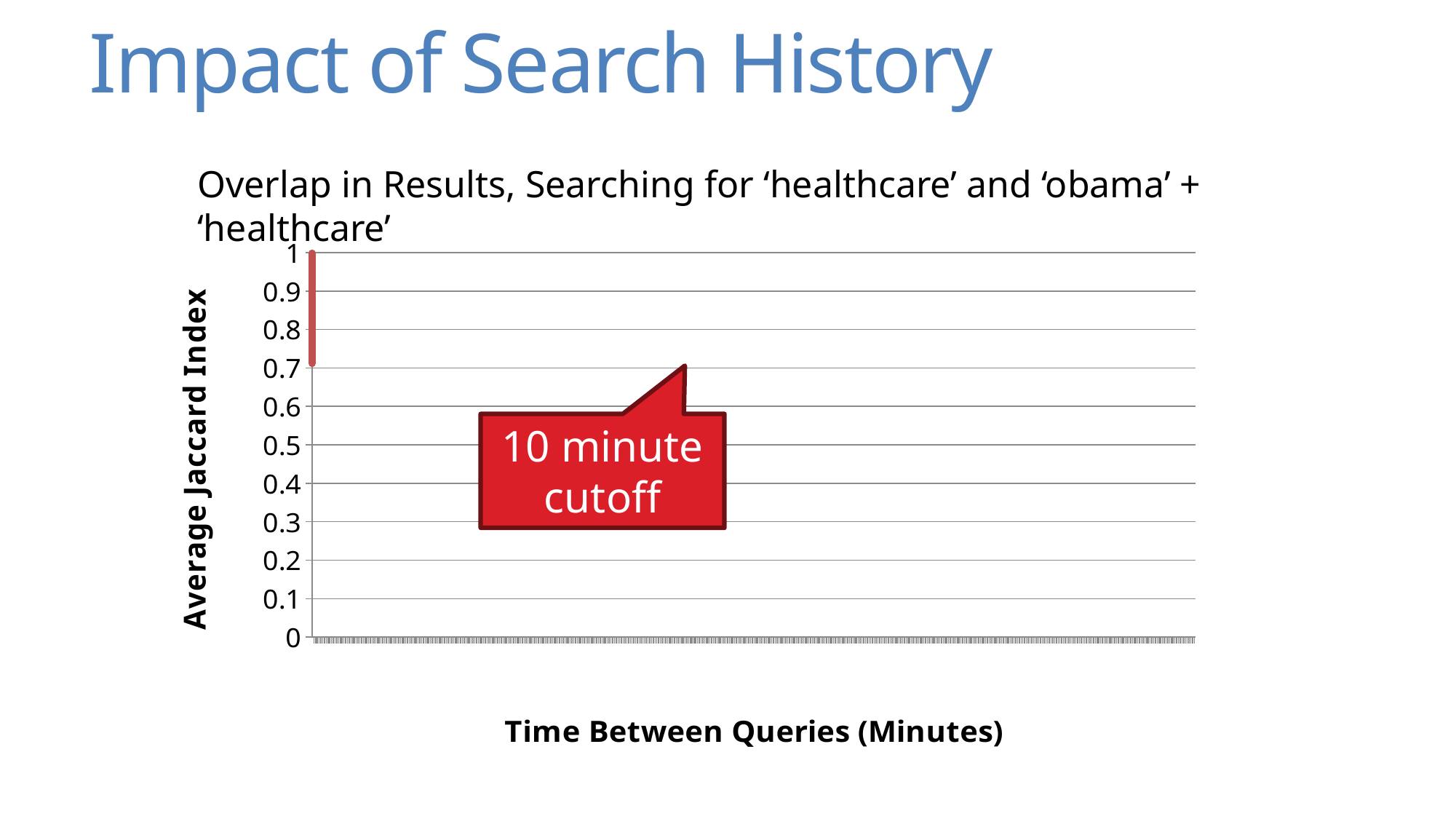
What is the title of the chart? Overlap in Results, Searching for ‘healthcare’ and ‘obama’ + ‘healthcare’ What is the label of the x axis of the chart? Time Between Queries (Minutes) Is the value of the red bar at the far left of the chart greater or less than 0.2? greater Is the value of the red bar at the far left of the chart greater or less than 0.5? greater What kind of chart is shown on the slide? line chart